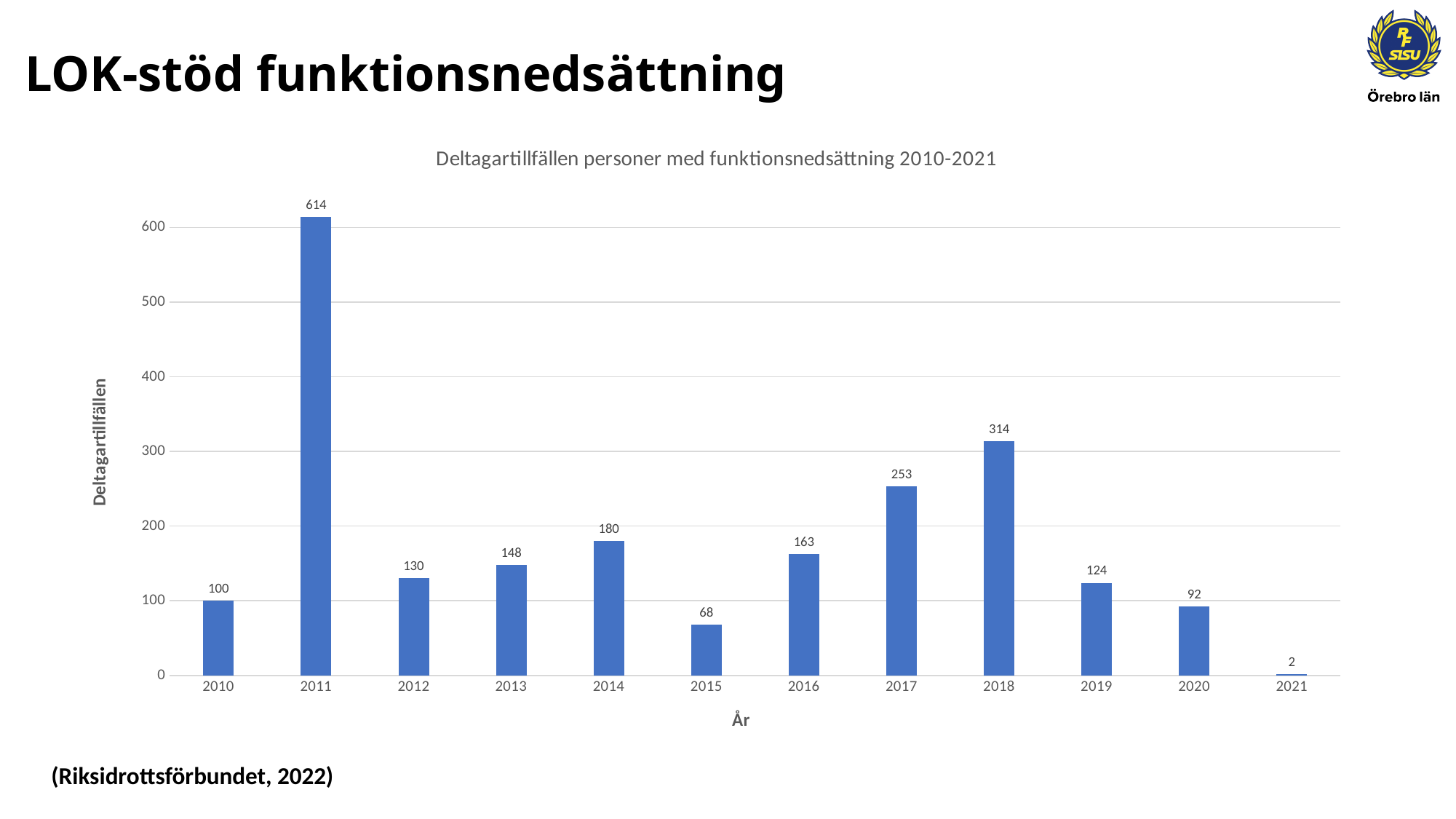
What is the value for 2011? 614 What is the value for 2015? 68 Which year has the lowest value? 2021 Do the values rise or fall from 2018 to 2021? Fall What is the difference between the values for 2018 and 2017? 61 Which year has the highest value? 2011 Which is larger, the value for 2014 or the value for 2016? 2014 What is the title of the chart? Deltagartillfällen personer med funktionsnedsättning 2010-2021 Is the value for 2019 greater or less than 100? greater How many years are shown on the x axis? 12 What kind of chart is shown? Bar chart What is the value for 2018? 314